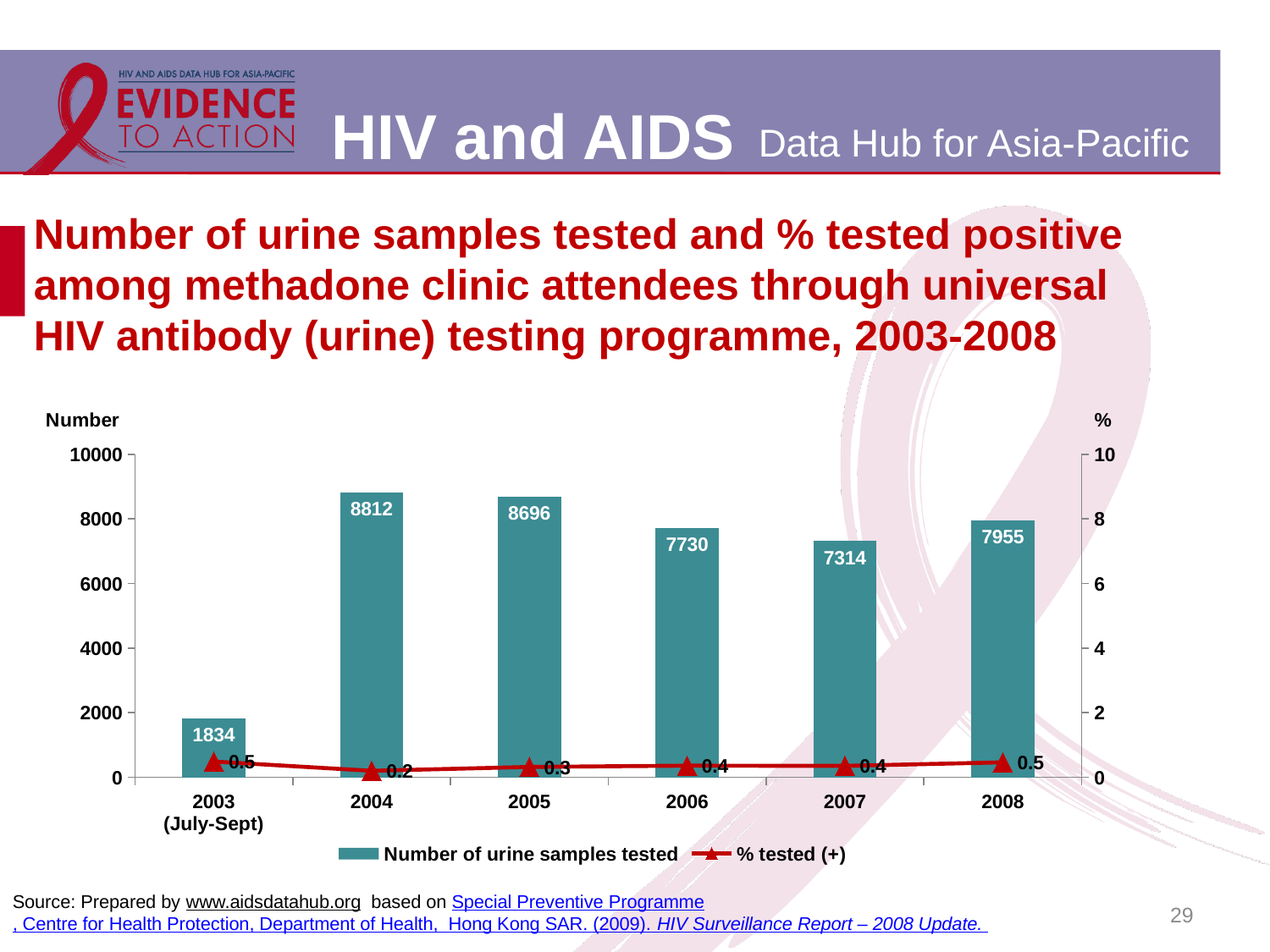
Which year had more urine samples tested, 2007 or 2008? 2008 Which year had the lowest % tested positive? 2004 How many urine samples were tested in 2004? 8812 How many years (categories) are shown on the x axis? 6 What is the label of the right-hand vertical axis? % What was the % tested positive in 2006? 0.4 Which year had the highest number of urine samples tested? 2004 How many series does the legend list? 2 Is the number of urine samples tested in 2006 greater or less than 6000? greater What is the difference in the number of urine samples tested between 2004 and 2005? 116 Which year had the lowest number of urine samples tested? 2003 (July-Sept) What kind of chart is used to show the number of urine samples tested? bar chart